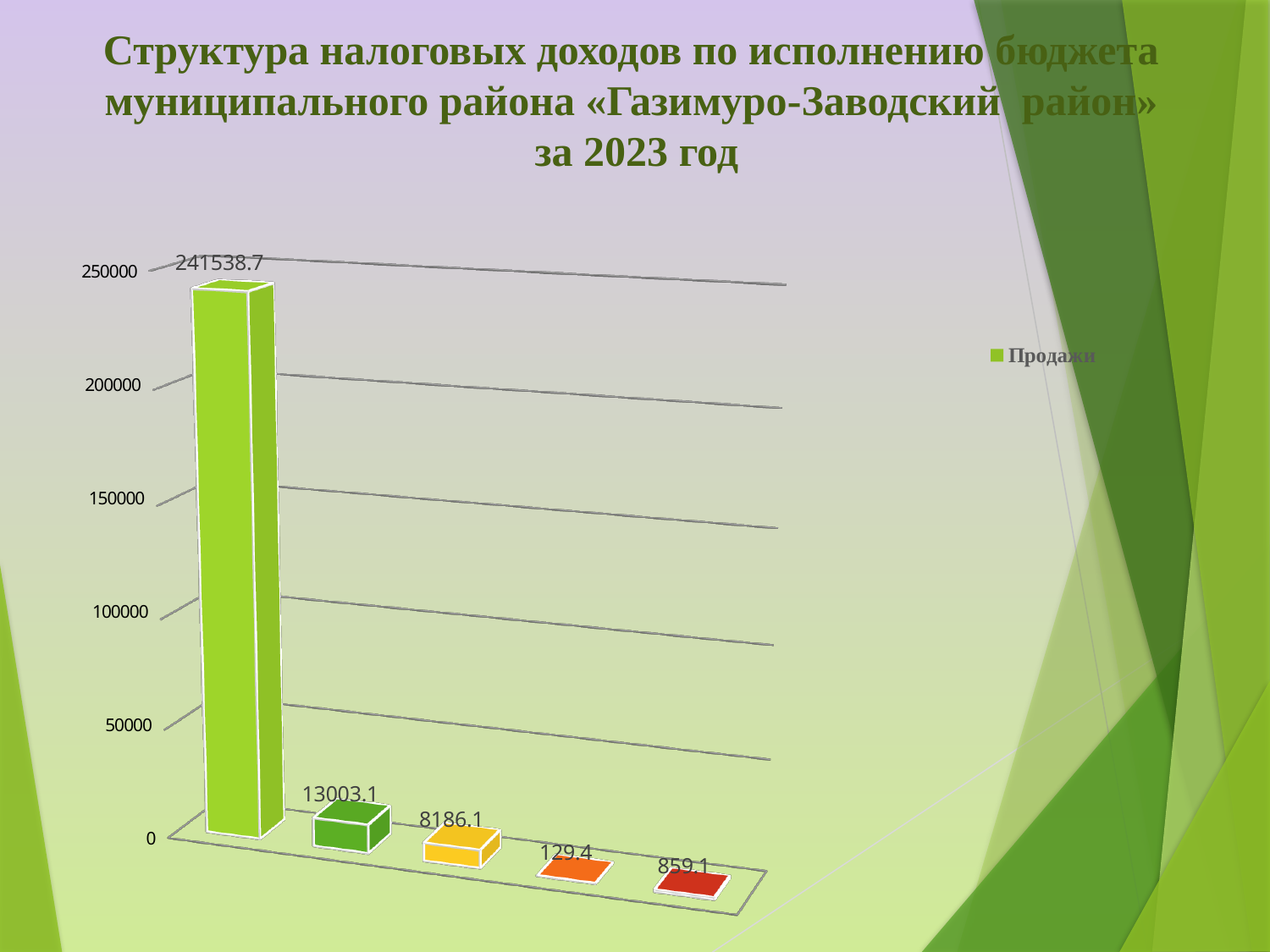
How many series does the legend list? 1 Which bar has the lowest value? the fourth (orange) bar, 129.4 What is the value shown on the fourth (orange) bar? 129.4 What is the difference between the second bar (13003.1) and the third bar (8186.1)? 4817 What is the value shown on the second (dark green) bar? 13003.1 What is the name of the series shown in the legend? Продажи What is the value shown on the third (yellow) bar? 8186.1 Is the value of the first bar greater or less than 200000? greater What is the value shown on the last (dark red) bar? 859.1 What kind of chart is shown on the slide? bar chart What is the value shown on the tallest (first, light green) bar? 241538.7 How many bars are plotted in the chart? 5